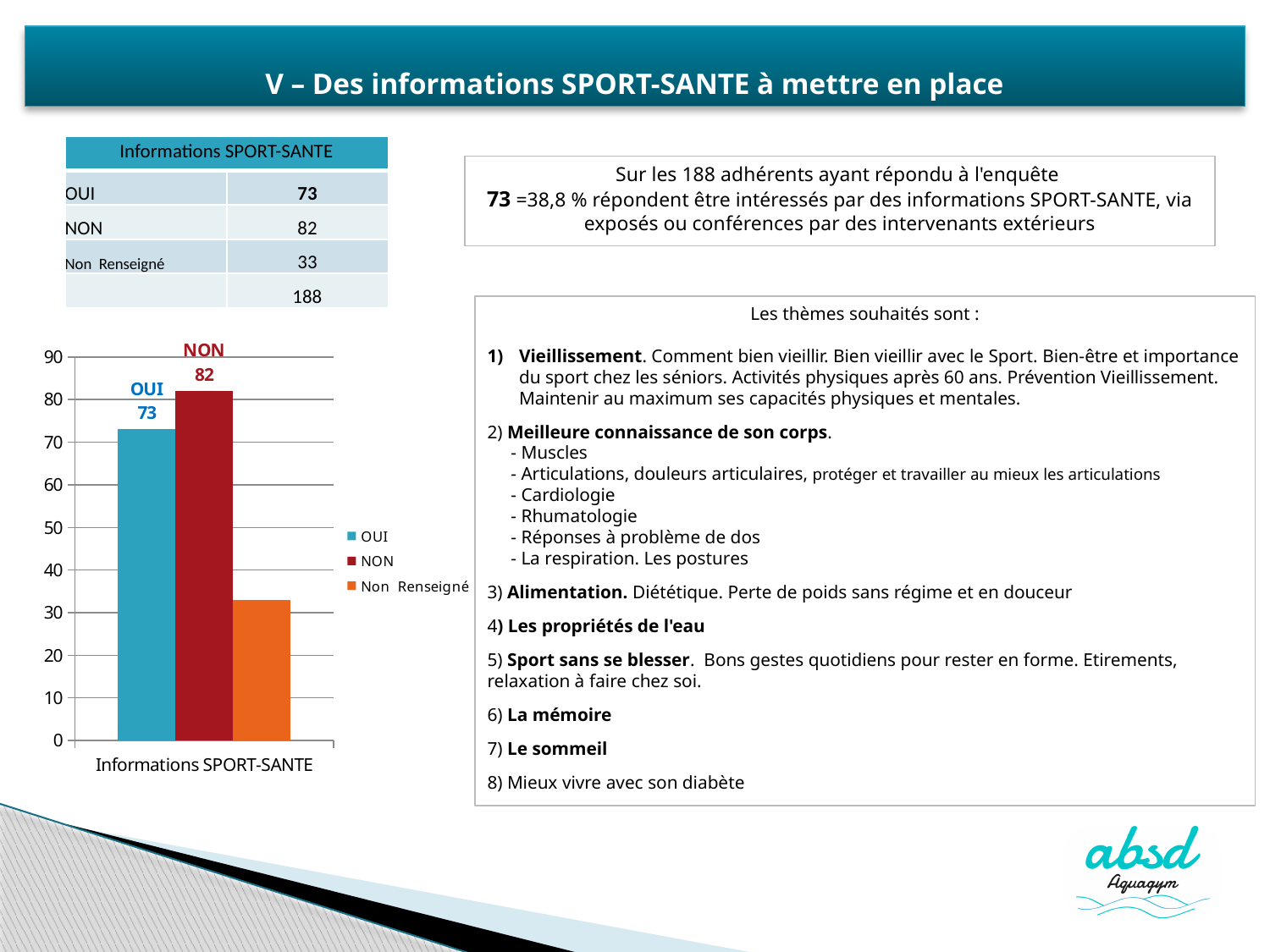
Which is larger in the chart, the OUI bar or the NON bar? NON Is the value of the Non Renseigné bar greater or less than 20? greater What is the value of the NON bar in the chart? 82 What kind of chart is shown on the slide? bar chart Which series has the tallest bar in the chart? NON How many series does the chart legend list? 3 What is the value of the OUI bar in the chart? 73 What is the category label shown on the x axis of the chart? Informations SPORT-SANTE Is the value of the Non Renseigné bar greater or less than 40? less Which series has the shortest bar in the chart? Non Renseigné How many categories are shown on the x axis of the chart? 1 What is the difference between the NON value and the OUI value in the chart? 9